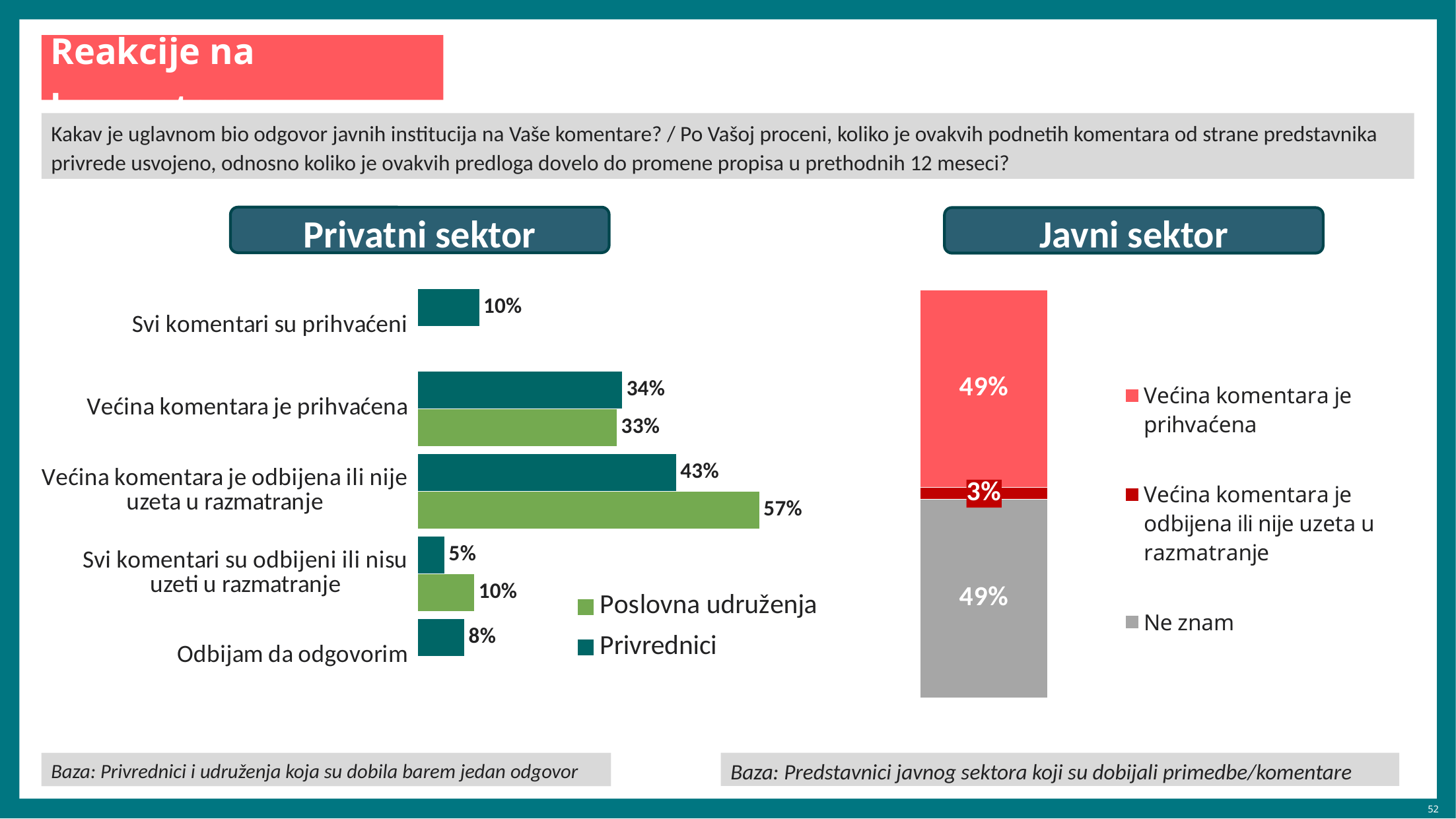
In the 'Privatni sektor' chart, which category has the lowest value for Privrednici? Svi komentari su odbijeni ili nisu uzeti u razmatranje In the 'Privatni sektor' chart, for 'Svi komentari su odbijeni ili nisu uzeti u razmatranje', which series has the larger value, Poslovna udruženja or Privrednici? Poslovna udruženja In the 'Javni sektor' chart, what is the value for 'Većina komentara je odbijena ili nije uzeta u razmatranje'? 3% In the 'Javni sektor' chart, what is the value for 'Ne znam'? 49% In the 'Privatni sektor' chart, what is the value for Privrednici for 'Odbijam da odgovorim'? 8% In the 'Privatni sektor' chart, what is the value for Privrednici for 'Većina komentara je odbijena ili nije uzeta u razmatranje'? 43% In the 'Privatni sektor' chart, which category has the highest value for Poslovna udruženja? Većina komentara je odbijena ili nije uzeta u razmatranje In the 'Privatni sektor' chart, what is the value for Poslovna udruženja for 'Većina komentara je odbijena ili nije uzeta u razmatranje'? 57% How many series does the legend of the 'Privatni sektor' chart list? 2 What kind of chart is the 'Privatni sektor' chart? Bar chart In the 'Privatni sektor' chart, what is the difference between the Poslovna udruženja and Privrednici values for 'Većina komentara je odbijena ili nije uzeta u razmatranje'? 14% In the 'Privatni sektor' chart, what is the value for Privrednici for 'Svi komentari su prihvaćeni'? 10%